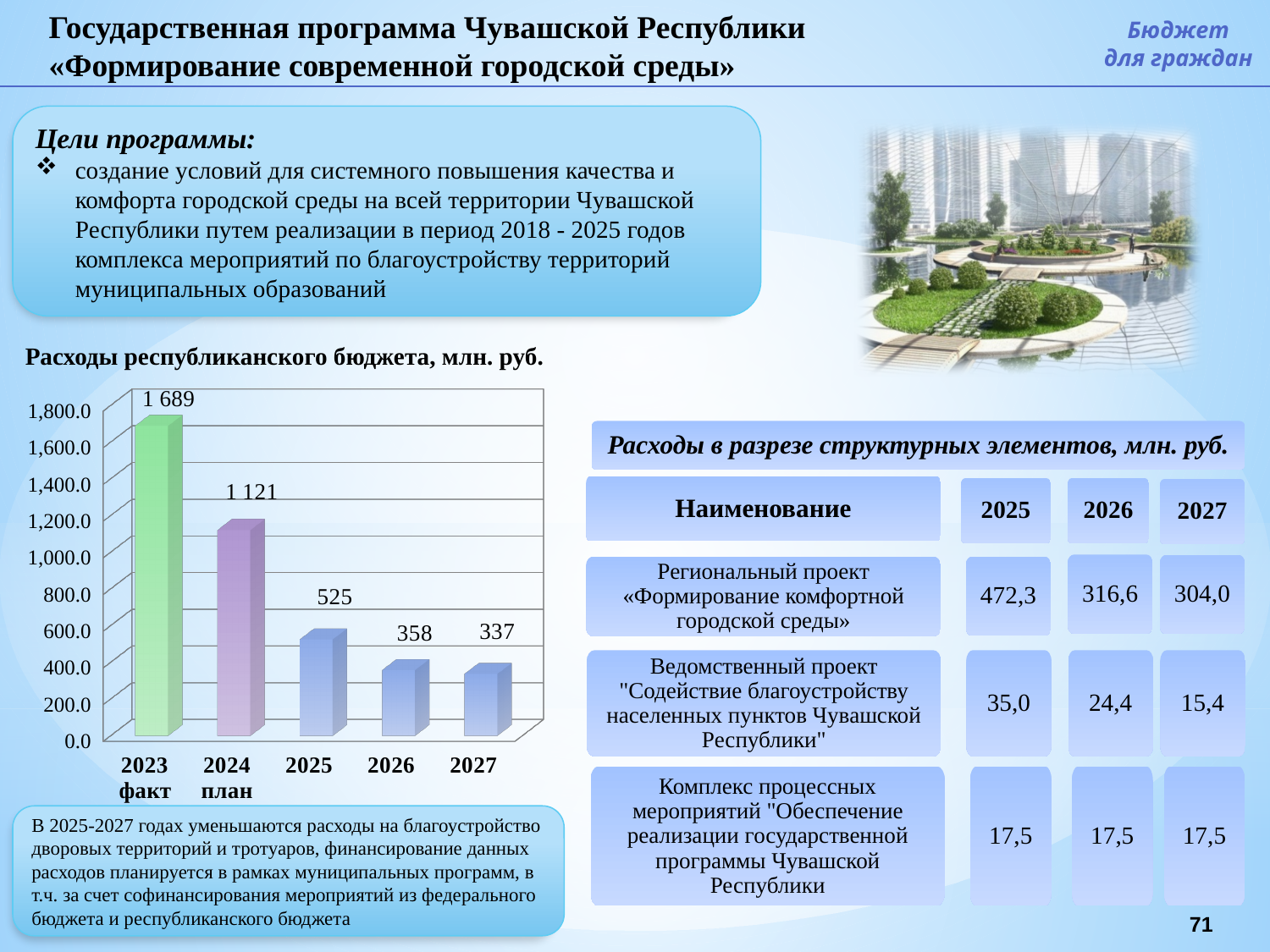
What is the value for 2025 in the chart 'Расходы республиканского бюджета, млн. руб.'? 525 What kind of chart is 'Расходы республиканского бюджета, млн. руб.'? bar chart How many bars are shown in the chart 'Расходы республиканского бюджета, млн. руб.'? 5 What is the value for 2024 план in the chart? 1 121 What is the value for 2027 in the chart? 337 Do the values in the chart rise or fall from 2023 to 2027? fall Which year has the lowest value in the chart? 2027 Which year has the highest value in the chart 'Расходы республиканского бюджета, млн. руб.'? 2023 факт Which is larger in the chart, the value for 2025 or the value for 2026? 2025 What is the value for 2023 факт in the chart 'Расходы республиканского бюджета, млн. руб.'? 1 689 What is the difference between the values for 2023 факт and 2024 план in the chart? 568 What is the difference between the values for 2026 and 2027 in the chart? 21